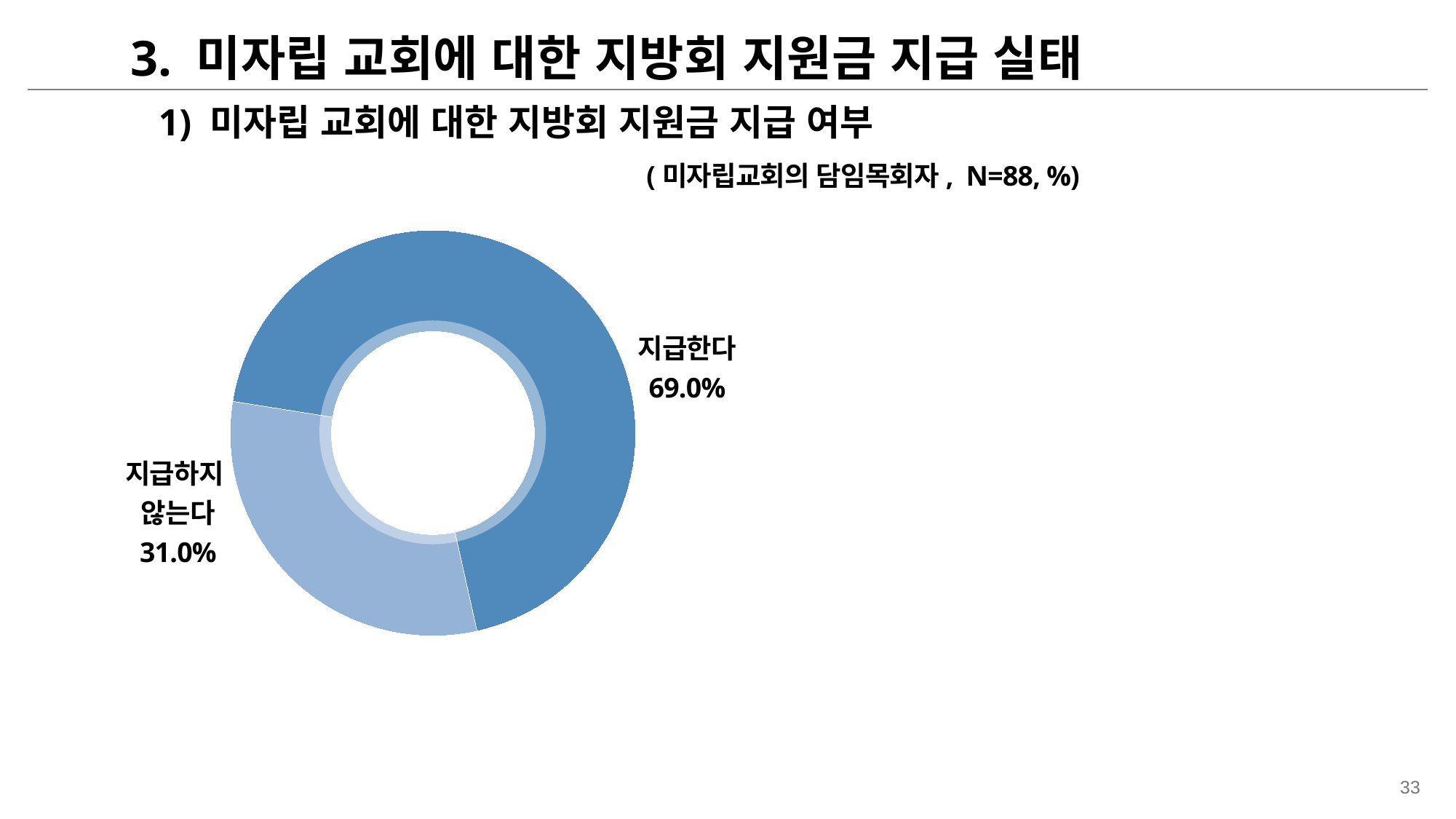
Which is larger, the share for 지급한다 or the share for 지급하지 않는다? 지급한다 Who are the respondents described in the note above the chart? 미자립교회의 담임목회자 What kind of chart is shown on the slide? Doughnut (pie) chart What percentage of respondents answered 지급한다? 69.0% What percentage of respondents answered 지급하지 않는다? 31.0% How many categories are shown in the chart? 2 Which category has the smallest share of the chart? 지급하지 않는다 Which category has the largest share of the chart? 지급한다 What is the sample size (N) stated for the chart? 88 What is the difference in percentage points between 지급한다 and 지급하지 않는다? 38.0 What is the total of the two percentages shown in the chart? 100.0%